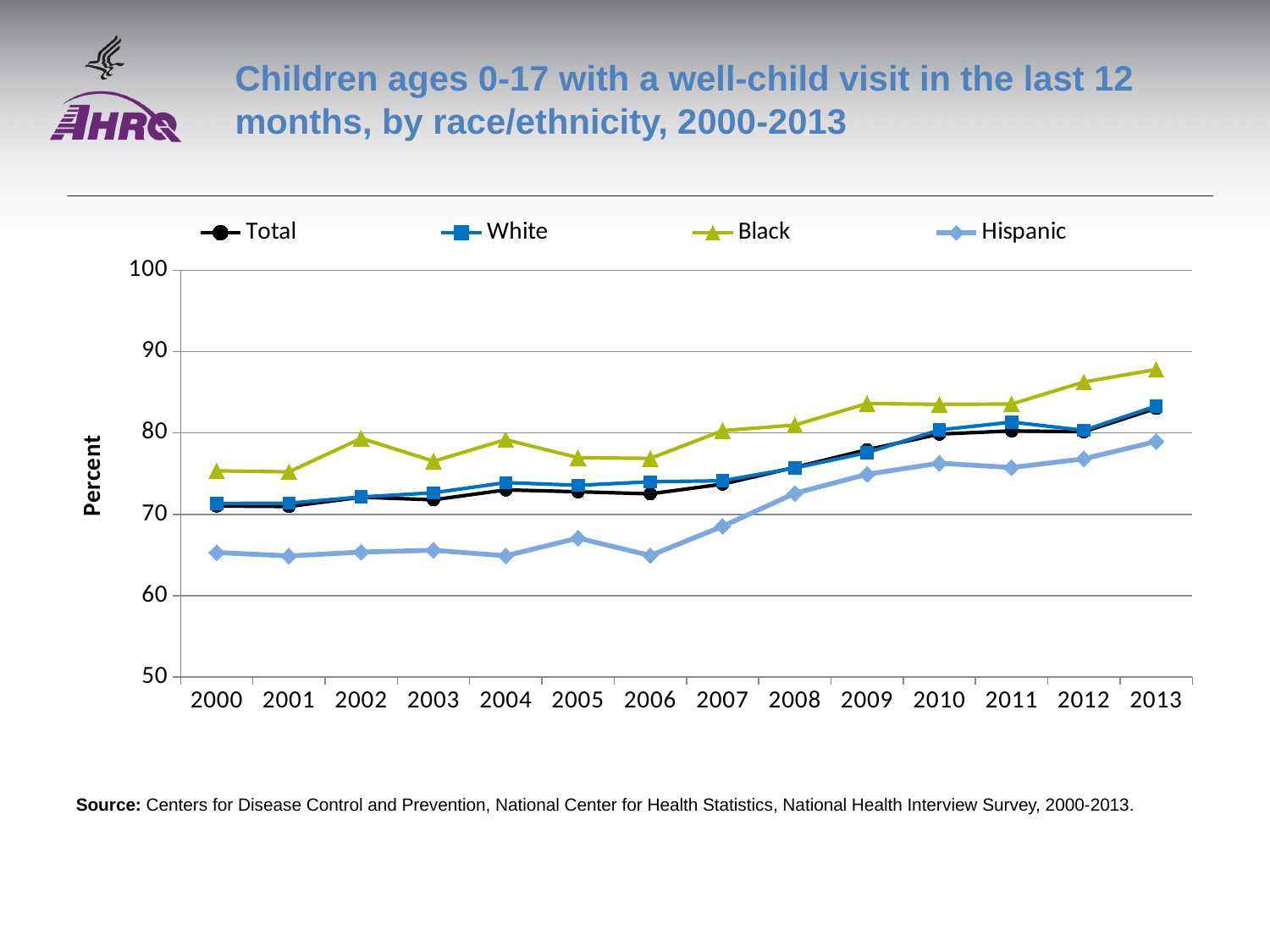
Does the Hispanic series rise or fall from 2006 to 2013? Rise Which series has the highest value in 2013? Black How many years are plotted along the x axis? 14 What is the label on the y axis? Percent How many series does the legend list? 4 In 2010, which is larger: the value for Black or the value for Hispanic? Black Is the value for Black in 2013 greater or less than 80? greater What kind of chart is shown on the slide? Line chart Which series has the lowest value in 2000? Hispanic Is the value for Hispanic in 2006 greater or less than 70? less Is the value for White in 2013 greater or less than 80? greater In 2005, which is larger: the value for White or the value for Hispanic? White